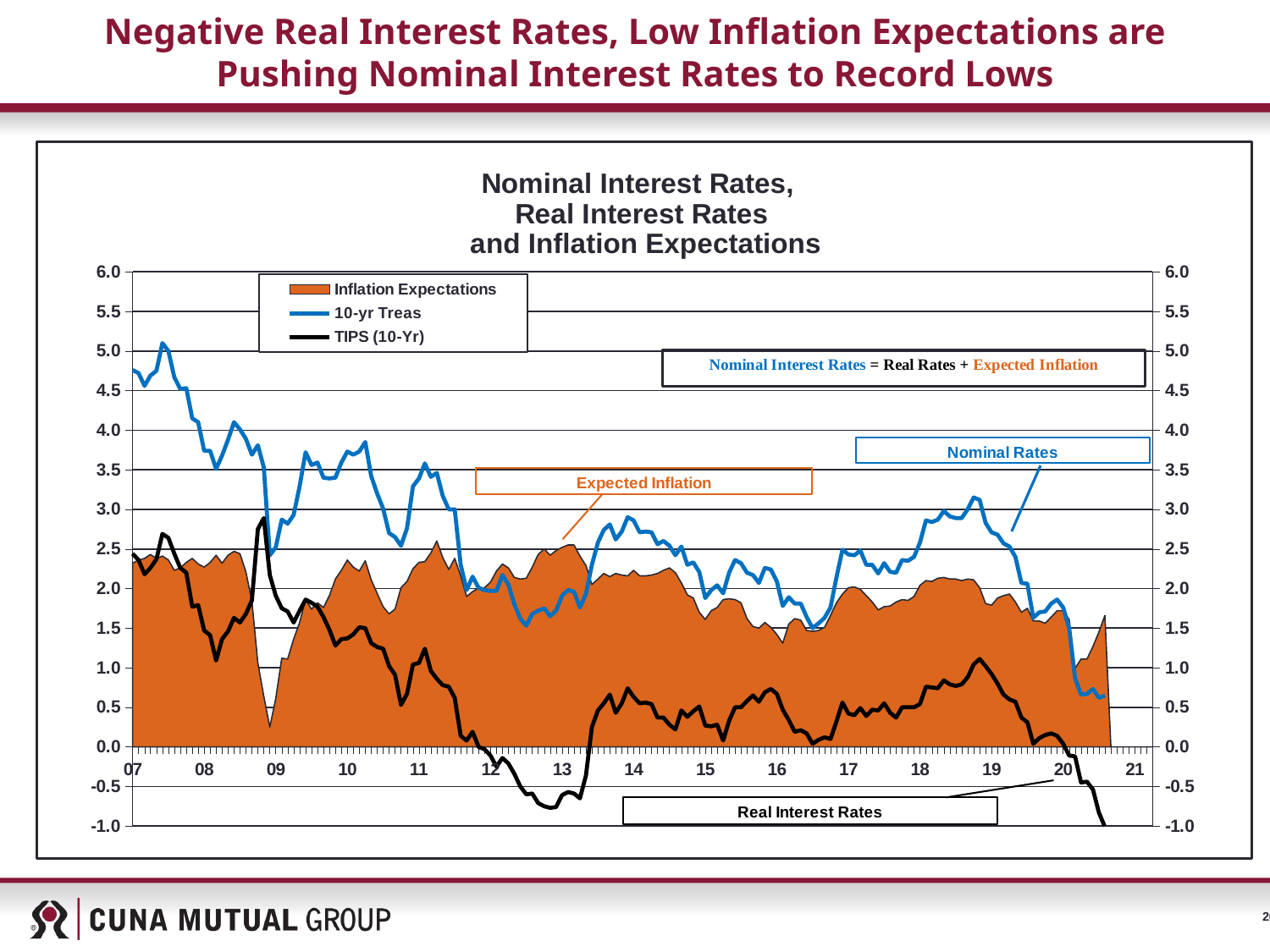
Does the 10-yr Treas series overall rise or fall from 2007 to 2020? fall How many year labels are shown on the x axis? 15 Which series reaches the highest value anywhere on the chart? 10-yr Treas Is the value of the TIPS (10-Yr) series at the end of the plotted period (2020) greater or less than 0.0? less Is the value of the 10-yr Treas series at the end of the plotted period (2020) greater or less than 1.0? less What kind of chart is shown on the slide? A combination of an area chart and line chart Is the value of the 10-yr Treas series at the start of 2007 greater or less than 4.0? greater What is the title of the chart? Nominal Interest Rates, Real Interest Rates and Inflation Expectations How many series does the legend list? 3 Which colour is used for the Inflation Expectations series? Orange In 2007, which is larger: the 10-yr Treas series or the TIPS (10-Yr) series? 10-yr Treas